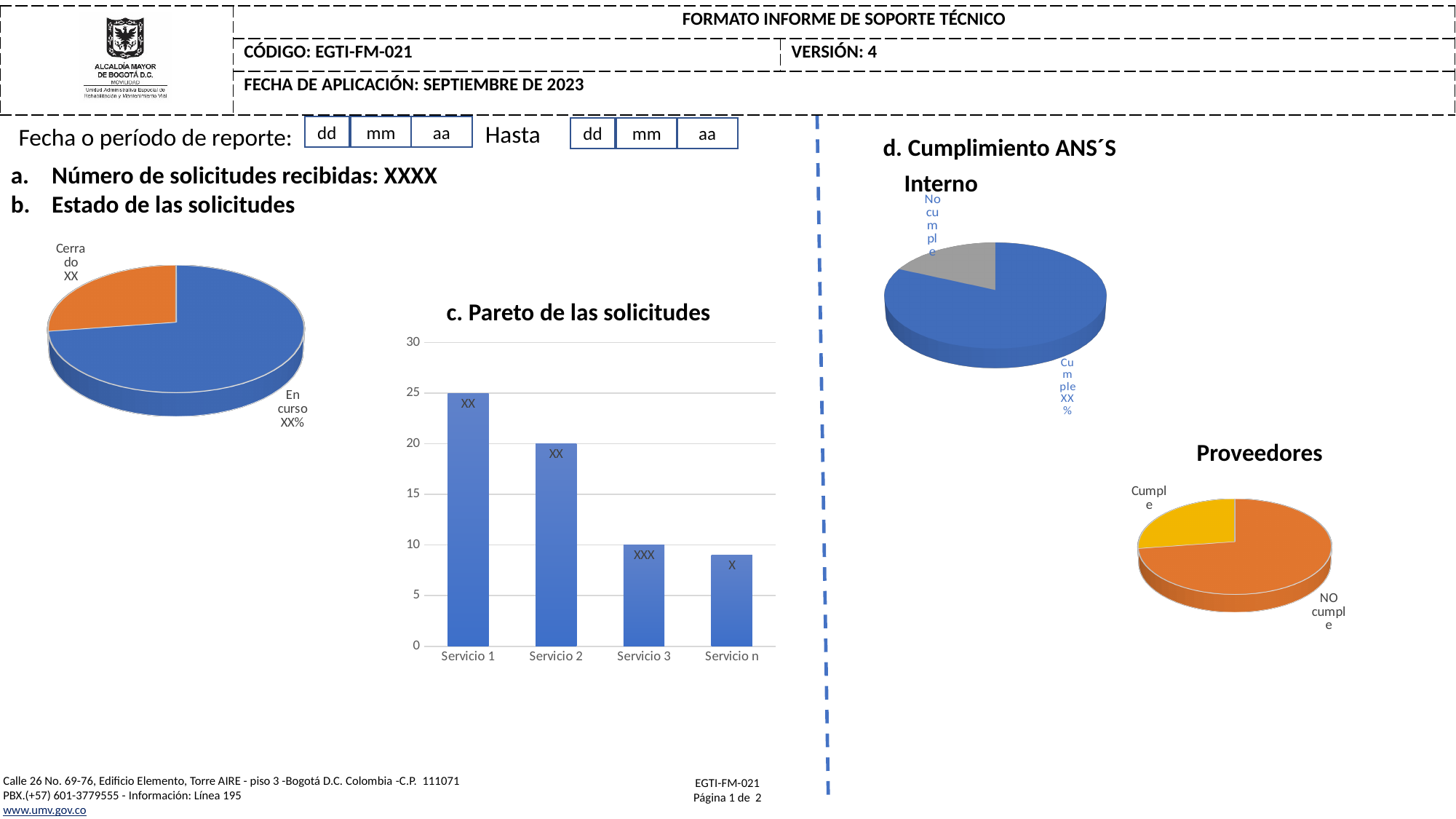
In "c. Pareto de las solicitudes", which category has the lowest bar? Servicio n In "c. Pareto de las solicitudes", do the bar values rise or fall from Servicio 1 to Servicio n? fall In "c. Pareto de las solicitudes", is the bar for Servicio n greater or less than 10? less In "c. Pareto de las solicitudes", is the bar for Servicio 1 greater or less than 20? greater What kind of chart is "c. Pareto de las solicitudes"? bar chart In "c. Pareto de las solicitudes", which bar is taller, Servicio 2 or Servicio 3? Servicio 2 In the "Proveedores" pie chart, which slice is larger, "Cumple" or "NO cumple"? NO cumple In "c. Pareto de las solicitudes", which category has the highest bar? Servicio 1 How many categories are shown on the x axis of "c. Pareto de las solicitudes"? 4 What kind of chart is used for "Estado de las solicitudes"? pie chart In the "Estado de las solicitudes" pie chart, which slice is larger, "Cerrado" or "En curso"? En curso